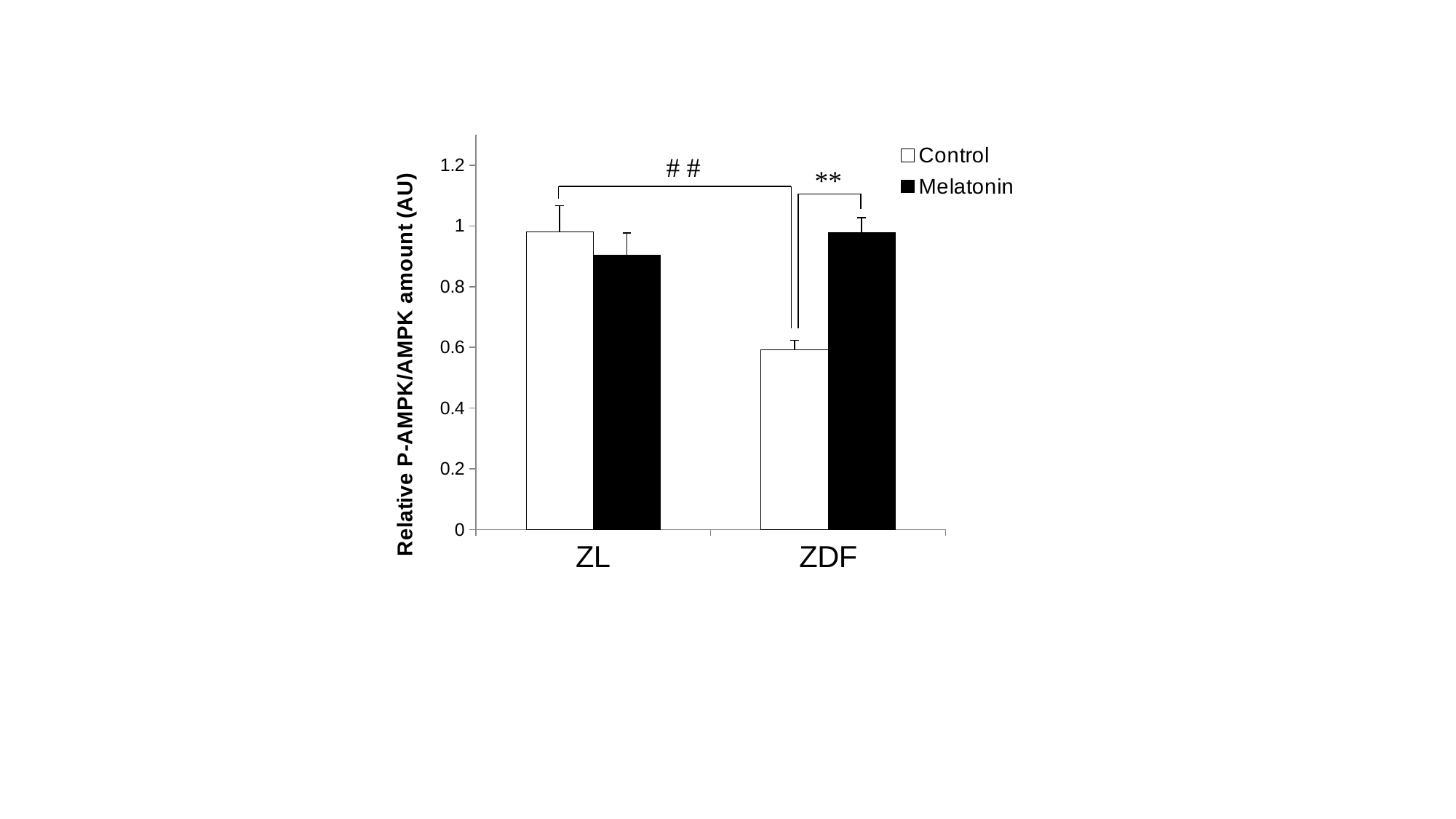
What kind of chart is shown on the slide? bar chart Is the Control value for ZL greater or less than 0.8? greater What is the label of the y axis? Relative P-AMPK/AMPK amount (AU) Is the Control value for ZDF greater or less than 0.8? less Is the Melatonin value for ZDF greater or less than 0.8? greater How many categories are shown on the x axis? 2 Which series is shown with black bars? Melatonin For ZL, which is larger, the Control value or the Melatonin value? Control For ZDF, which is larger, the Control value or the Melatonin value? Melatonin How many series does the legend list? 2 Which bar is the lowest in the chart? ZDF Control